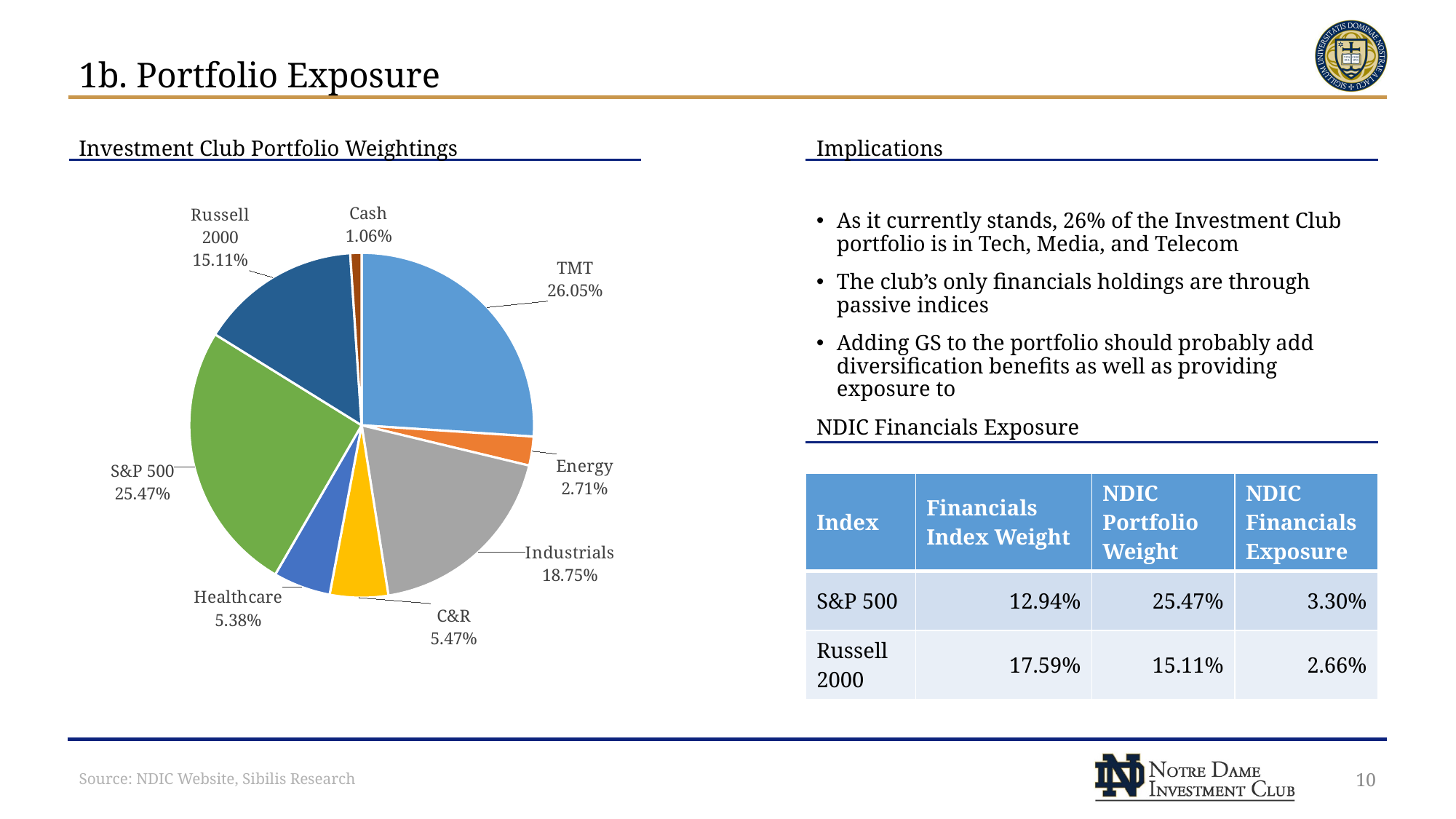
What is the difference between the TMT and S&P 500 weightings in the pie chart? 0.58% What is the portfolio weighting for TMT in the pie chart? 26.05% What is the portfolio weighting for Industrials in the pie chart? 18.75% Which category has the smallest slice in the pie chart? Cash What is the portfolio weighting for Energy in the pie chart? 2.71% What is the difference between the Industrials and Russell 2000 weightings in the pie chart? 3.64% What kind of chart is shown under "Investment Club Portfolio Weightings"? Pie chart How many categories are shown in the pie chart? 8 Which category has the largest slice in the pie chart? TMT What share of the pie does S&P 500 represent? 25.47% What is the portfolio weighting for Cash in the pie chart? 1.06% Which has a larger weighting in the pie chart, Healthcare or C&R? C&R